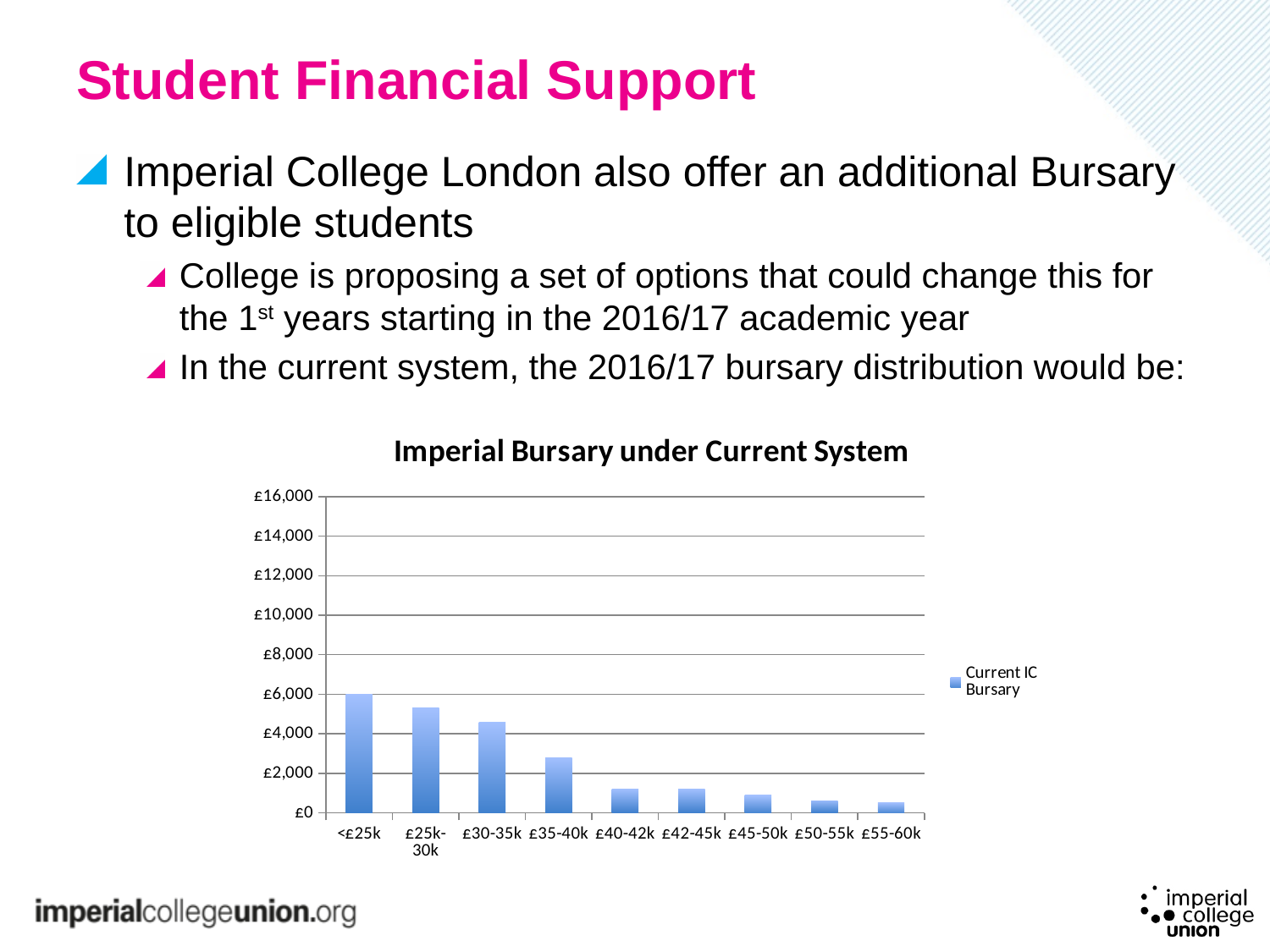
How many series does the chart's legend list? 1 Which is larger, the value for £30-35k or the value for £35-40k? £30-35k Do the bursary values rise or fall as household income increases along the x axis? fall How many income categories are shown on the x axis of the chart? 9 What is the title of the chart? Imperial Bursary under Current System Is the value for £25k-30k greater or less than £4,000? greater Which income category has the lowest bursary value in the chart? £55-60k What kind of chart is shown on the slide? bar chart Is the value for £45-50k greater or less than £2,000? less Is the value for £35-40k greater or less than £4,000? less Which income category has the highest bursary value in the chart? <£25k What is the name of the series shown in the chart's legend? Current IC Bursary